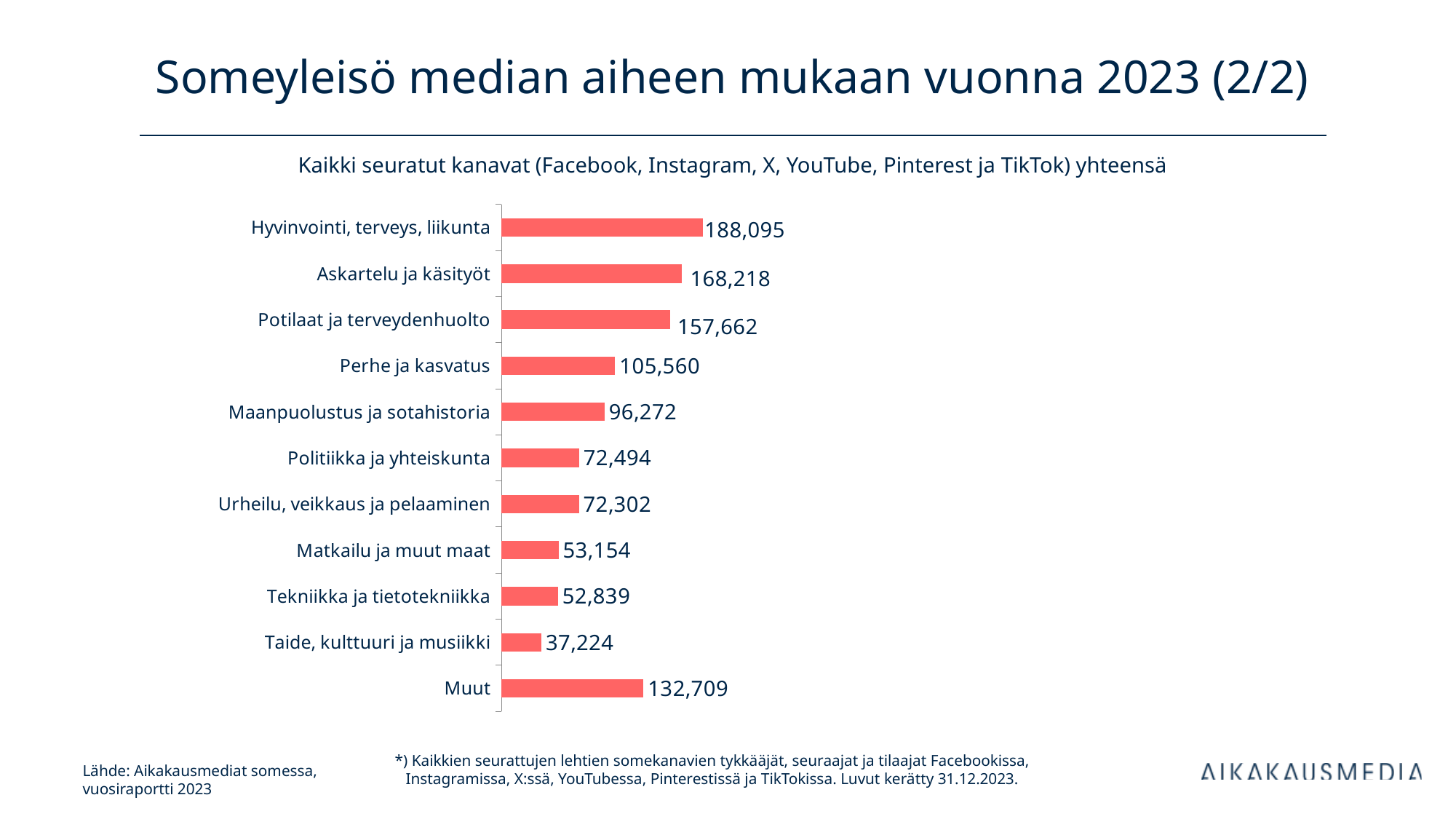
Which is larger, Muut or Perhe ja kasvatus? Muut Which is larger, Matkailu ja muut maat or Tekniikka ja tietotekniikka? Matkailu ja muut maat Which category has the highest value? Hyvinvointi, terveys, liikunta What kind of chart is shown on the slide? Bar chart What is the difference between Perhe ja kasvatus and Taide, kulttuuri ja musiikki? 68,336 What is the subtitle shown above the chart? Kaikki seuratut kanavat (Facebook, Instagram, X, YouTube, Pinterest ja TikTok) yhteensä How many categories are shown in the chart? 11 What is the value for Muut? 132,709 Which category has the lowest value? Taide, kulttuuri ja musiikki What is the value for Hyvinvointi, terveys, liikunta? 188,095 What is the difference between Askartelu ja käsityöt and Potilaat ja terveydenhuolto? 10,556 What is the value for Maanpuolustus ja sotahistoria? 96,272